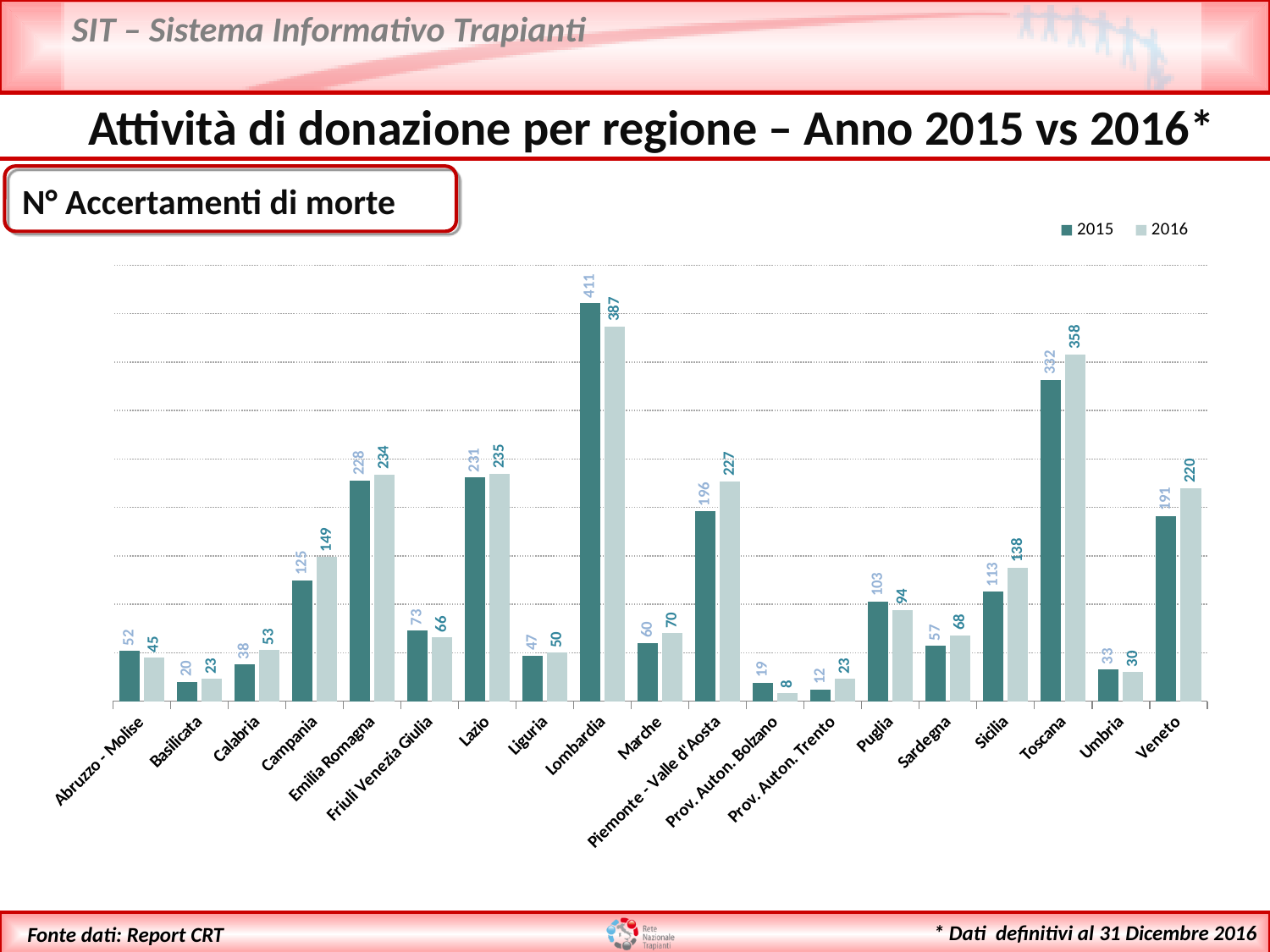
How many regions are shown on the x axis? 19 Which region has the highest 2016 value? Lombardia What is the 2016 value for Toscana? 358 Which is larger for Puglia, the 2015 value or the 2016 value? 2015 What is the difference between the 2016 and 2015 values for Veneto? 29 Which region has the lowest 2016 value? Prov. Auton. Bolzano What is the 2015 value for Piemonte - Valle d'Aosta? 196 What is the 2015 value for Lombardia? 411 Which region has the lowest 2015 value? Prov. Auton. Trento What is the title shown in the box above the chart? N° Accertamenti di morte How many series does the legend list? 2 What kind of chart is shown? Bar chart